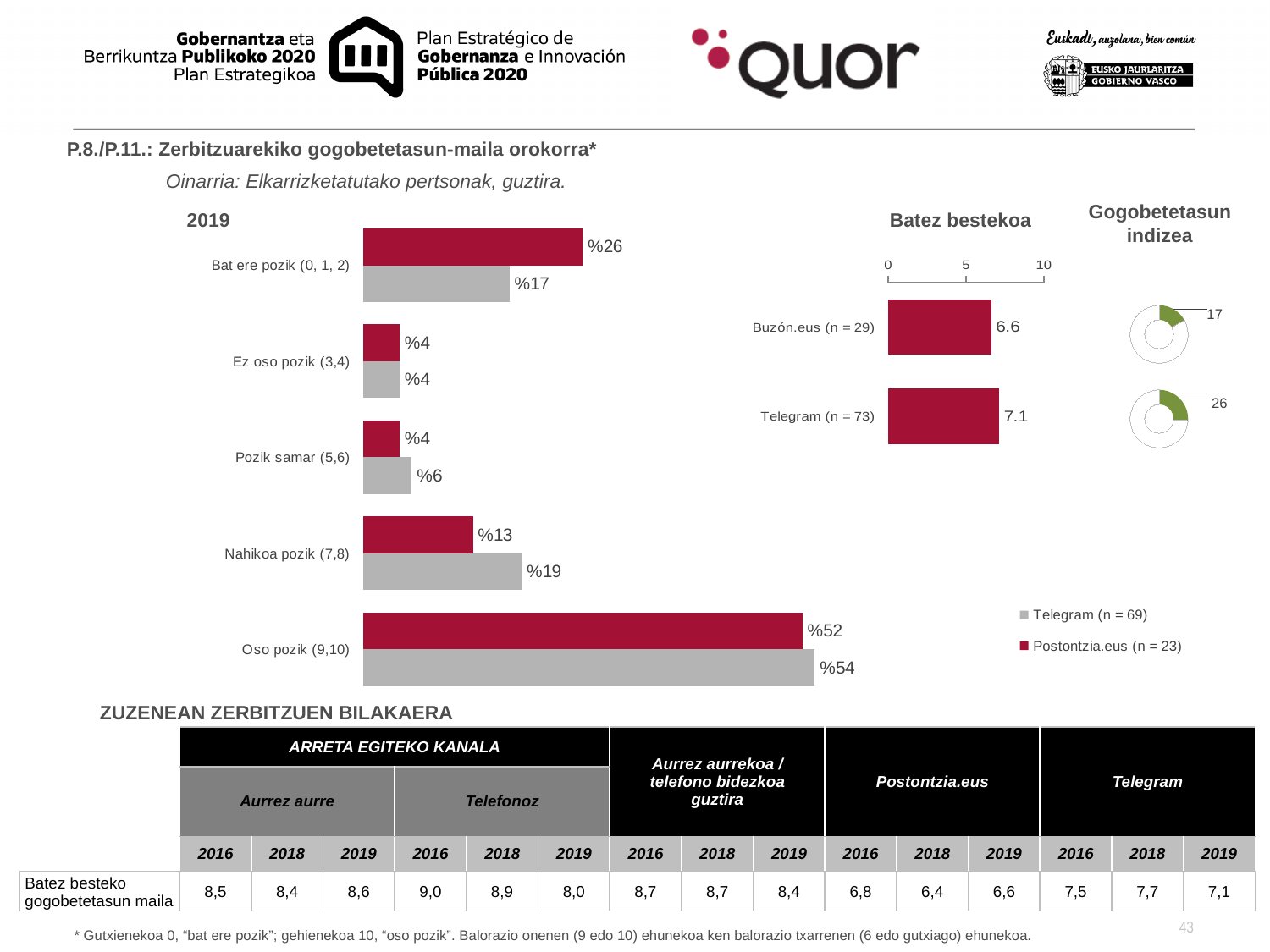
In the 2019 bar chart, what is the value for Postontzia.eus in the 'Oso pozik (9,10)' category? %52 What kind of chart is the 2019 chart on the left? bar chart How many categories are shown in the 2019 bar chart? 5 In the 'Batez bestekoa' chart, what is the value for Telegram (n = 73)? 7.1 In the 2019 bar chart, which is larger for 'Nahikoa pozik (7,8)': Telegram or Postontzia.eus? Telegram In the 'Gogobetetasun indizea' donut charts, what value is shown for the lower (Telegram) donut? 26 In the 2019 bar chart, what is the value for Telegram in the 'Nahikoa pozik (7,8)' category? %19 In the 2019 bar chart, what is the value for Telegram in the 'Bat ere pozik (0, 1, 2)' category? %17 In the 2019 bar chart, which category has the highest value for Telegram? Oso pozik (9,10) How many series does the legend of the 2019 bar chart list? 2 In the 2019 bar chart, what is the difference between the Postontzia.eus and Telegram values for 'Bat ere pozik (0, 1, 2)'? %9 In the 'Batez bestekoa' chart, which has the lower value: Buzón.eus or Telegram? Buzón.eus